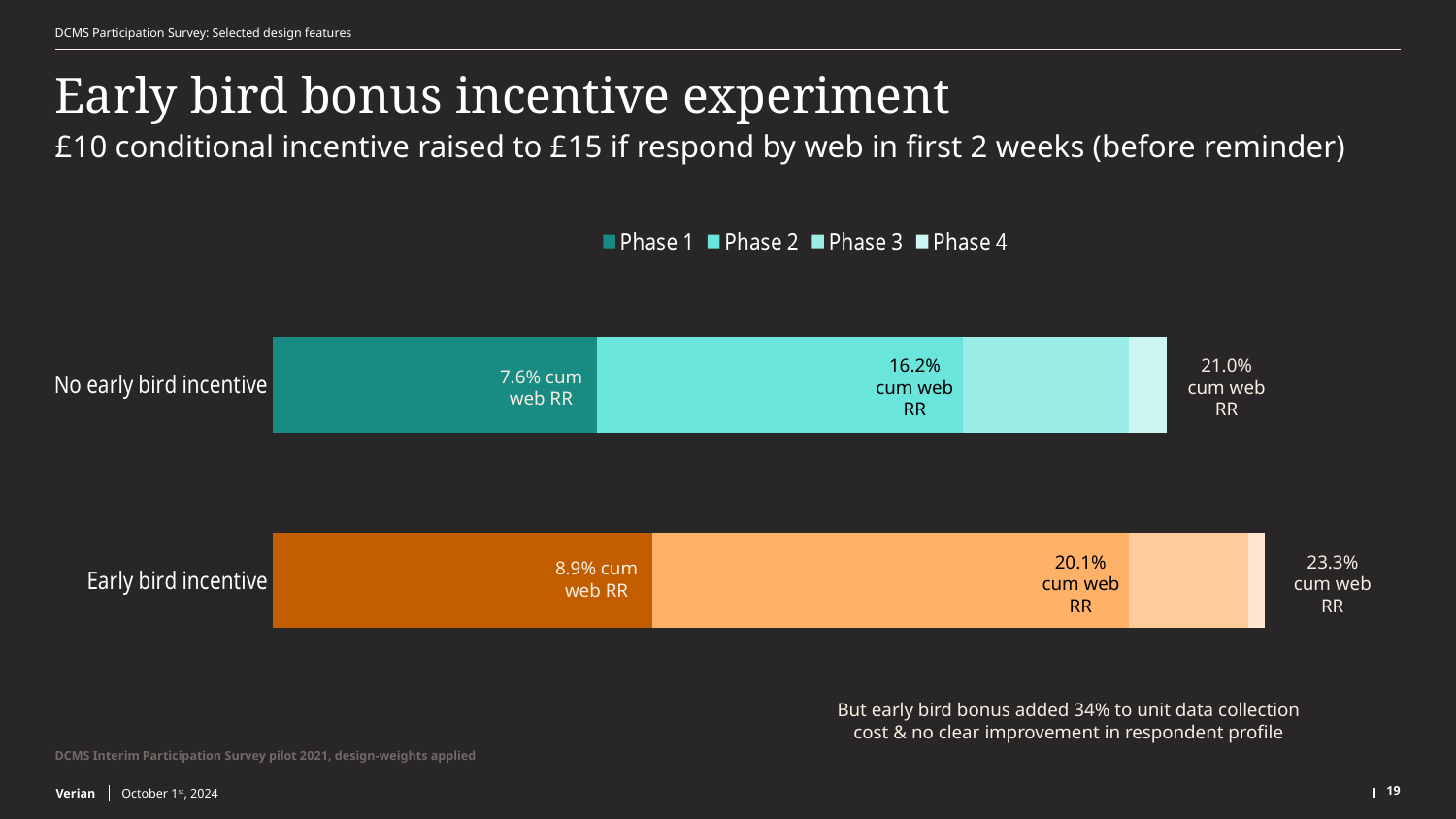
What is the difference between the Phase 1 cumulative web response rates of the 'Early bird incentive' (8.9%) and 'No early bird incentive' (7.6%) bars? 1.3% Which bar has the higher final cumulative web response rate, 'No early bird incentive' or 'Early bird incentive'? Early bird incentive What is the cumulative web response rate after Phase 1 for the 'No early bird incentive' bar? 7.6% cum web RR What is the cumulative web response rate after Phase 1 for the 'Early bird incentive' bar? 8.9% cum web RR What is the final cumulative web response rate shown at the end of the 'Early bird incentive' bar? 23.3% cum web RR What is the difference between the Phase 2 cumulative web response rates of the 'Early bird incentive' (20.1%) and 'No early bird incentive' (16.2%) bars? 3.9% What kind of chart is shown on the slide? Stacked bar chart How many categories (bars) are plotted in the chart? 2 How many series does the legend list? 4 What is the difference between the final cumulative web response rates of the 'Early bird incentive' (23.3%) and 'No early bird incentive' (21.0%) bars? 2.3% What is the cumulative web response rate after Phase 2 for the 'No early bird incentive' bar? 16.2% cum web RR What are the four entries listed in the chart legend? Phase 1, Phase 2, Phase 3, Phase 4